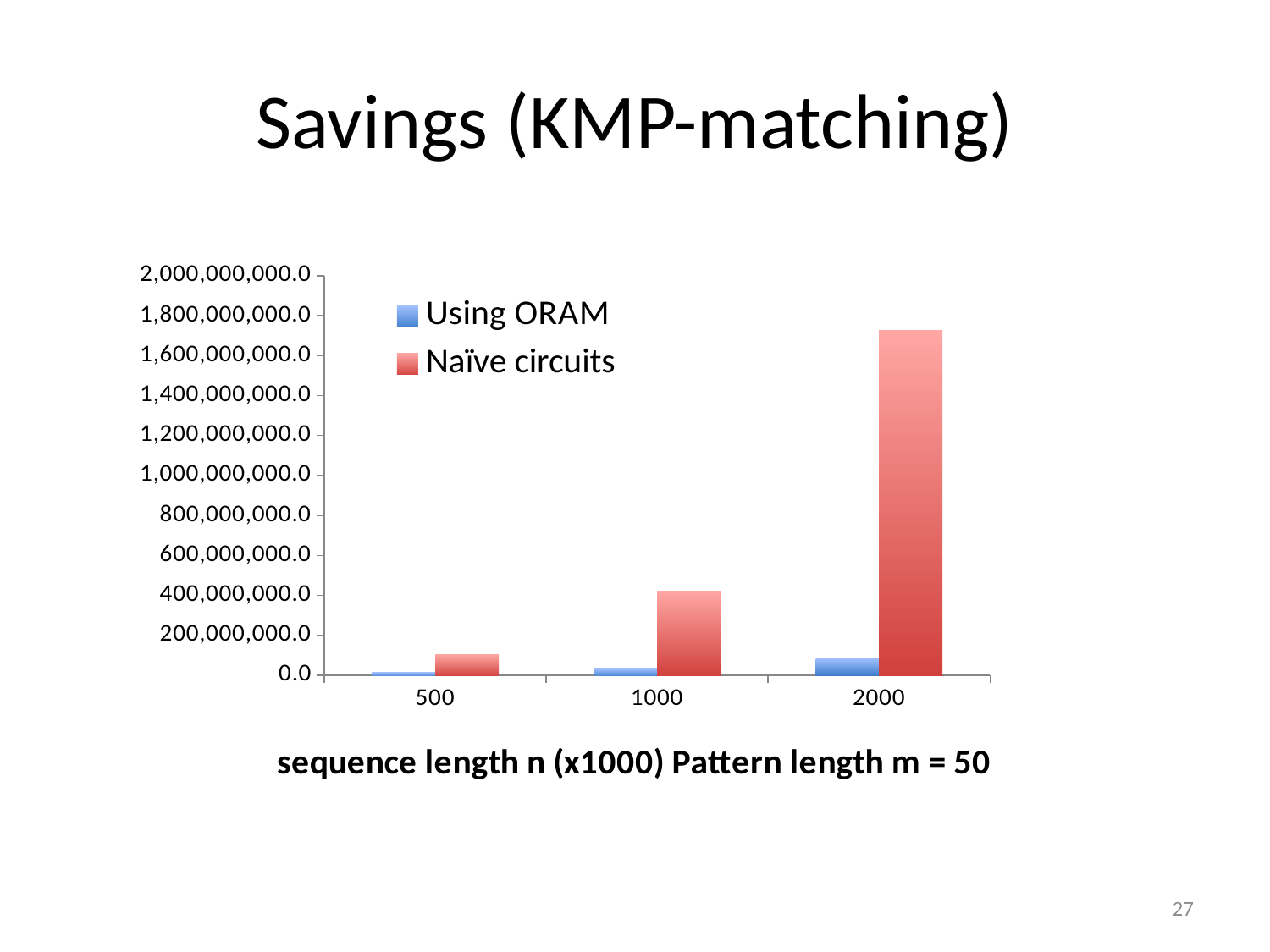
For the Naïve circuits series, which sequence length has the lowest value? 500 Is the Naïve circuits value at sequence length 1000 greater or less than 200,000,000.0? greater Is the Naïve circuits value at sequence length 2000 greater or less than 1,600,000,000.0? greater How many sequence length categories are shown on the x axis? 3 Which is larger at sequence length 1000: Using ORAM or Naïve circuits? Naïve circuits How many series does the legend list? 2 Which series has the highest bar at sequence length 2000? Naïve circuits What is the x-axis title of the chart? sequence length n (x1000) Pattern length m = 50 Is the Naïve circuits value at sequence length 500 greater or less than 200,000,000.0? less What kind of chart is shown on the slide? bar chart Do the Naïve circuits values rise or fall as sequence length increases from 500 to 2000? rise